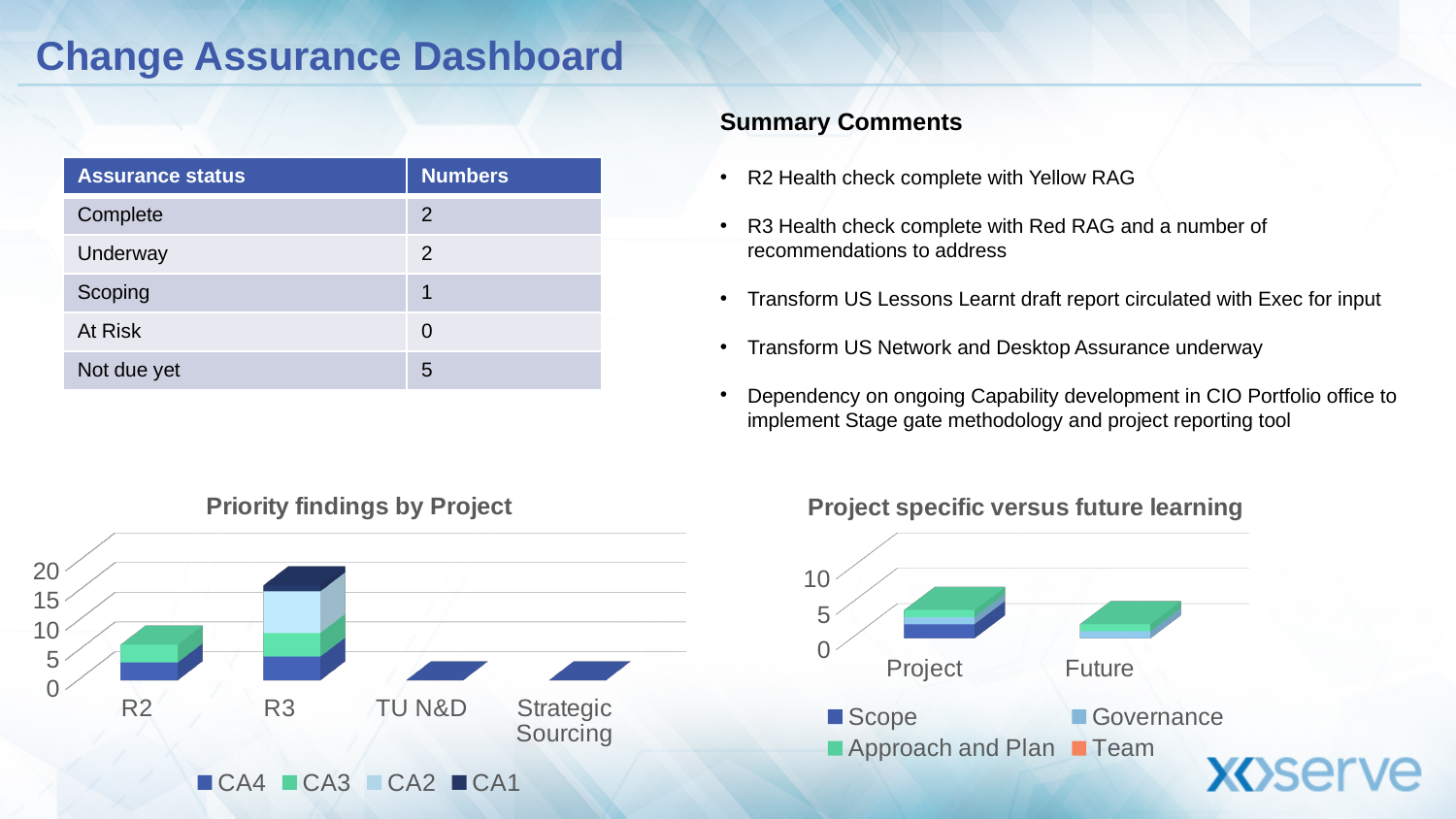
How many series does the legend of the 'Priority findings by Project' chart list? 4 What kind of chart is the 'Project specific versus future learning' chart? bar chart How many series does the legend of the 'Project specific versus future learning' chart list? 4 In the 'Priority findings by Project' chart, which is larger, the total for R2 or the total for R3? R3 In the 'Priority findings by Project' chart, is the total for R3 greater or less than 15? greater How many project categories are shown on the x axis of the 'Priority findings by Project' chart? 4 In the 'Priority findings by Project' chart, which project has the highest total of priority findings? R3 In the 'Project specific versus future learning' chart, which is larger, the total for Project or the total for Future? Project How many categories are shown on the x axis of the 'Project specific versus future learning' chart? 2 What are the legend entries of the 'Priority findings by Project' chart? CA4, CA3, CA2, CA1 What kind of chart is the 'Priority findings by Project' chart? bar chart In the 'Priority findings by Project' chart, is the total for TU N&D greater or less than 5? less